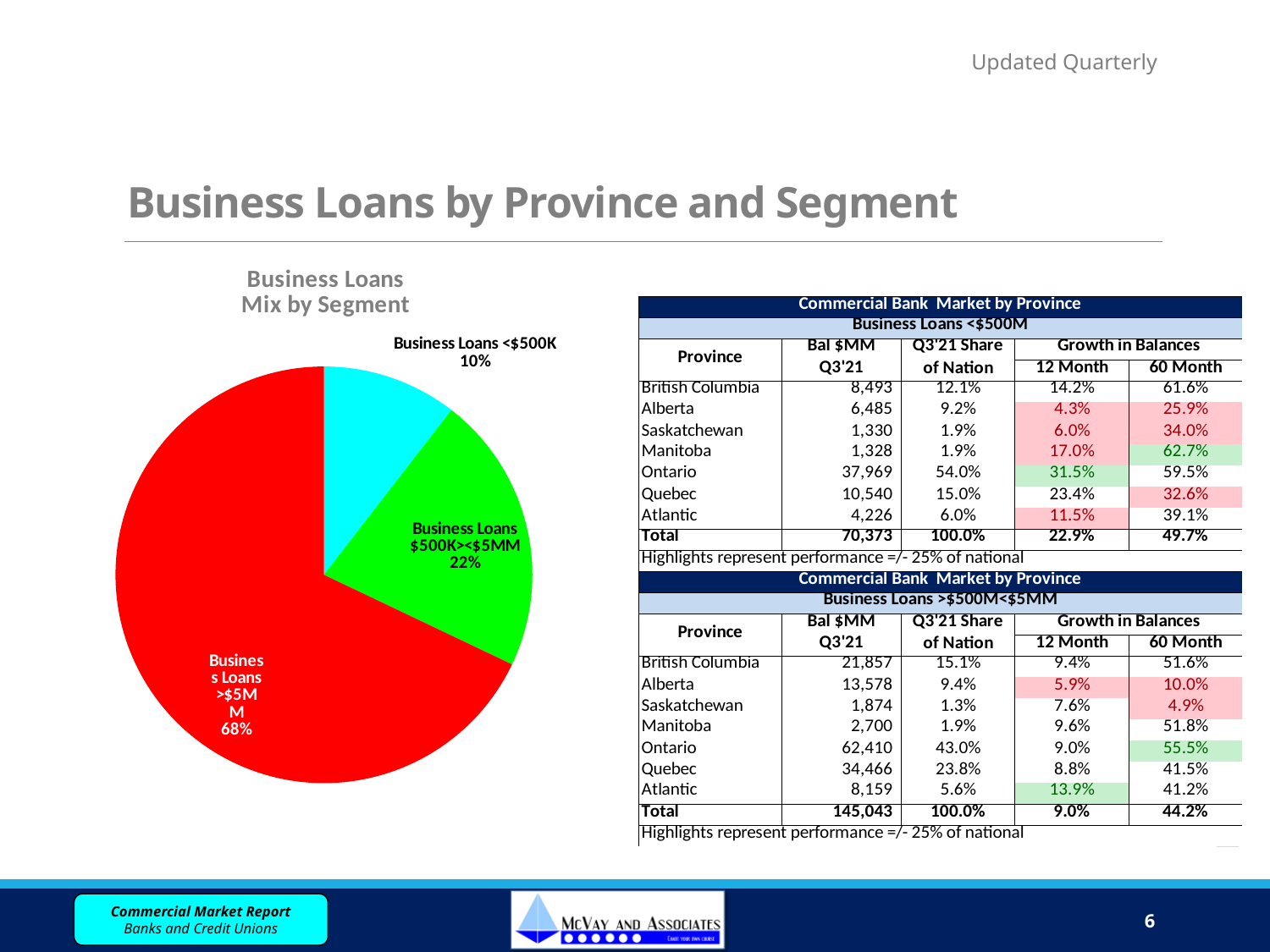
Which segment has the largest slice of the pie? Business Loans >$5MM What colour is the Business Loans >$5MM slice of the pie? red What share of the pie is Business Loans <$500K? 10% Which segment has the smallest slice of the pie? Business Loans <$500K What share of the pie is Business Loans $500K><$5MM? 22% What is the difference in percentage points between the Business Loans >$5MM slice and the Business Loans $500K><$5MM slice? 46 What share of the pie is Business Loans >$5MM? 68% What is the difference in percentage points between the Business Loans $500K><$5MM slice and the Business Loans <$500K slice? 12 What is the title of the pie chart? Business Loans Mix by Segment Which is larger, the Business Loans <$500K slice or the Business Loans $500K><$5MM slice? Business Loans $500K><$5MM What kind of chart is shown on the slide? pie chart How many slices does the pie chart have? 3